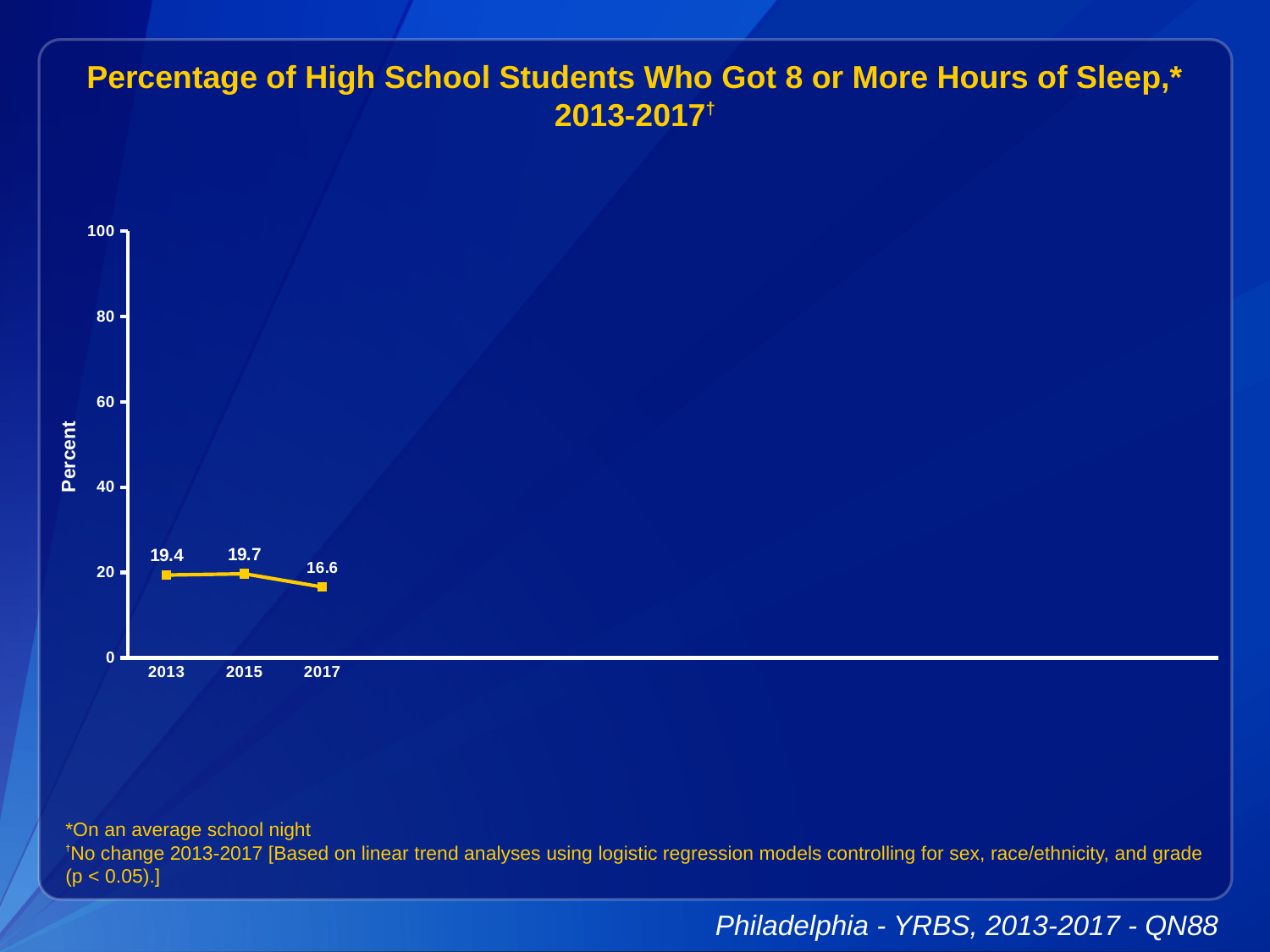
Which year has a larger value, 2013 or 2017? 2013 What is the difference between the 2015 and 2017 values? 3.1 Is the value for 2017 greater or less than 20? less What percentage of high school students got 8 or more hours of sleep in 2013? 19.4 What percentage of high school students got 8 or more hours of sleep in 2015? 19.7 What is the label of the y axis? Percent Which year has the highest percentage of students who got 8 or more hours of sleep? 2015 What kind of chart is shown on the slide? line chart How many years are plotted on the chart? 3 What percentage of high school students got 8 or more hours of sleep in 2017? 16.6 What is the difference between the 2013 and 2017 values? 2.8 Which year has the lowest percentage of students who got 8 or more hours of sleep? 2017